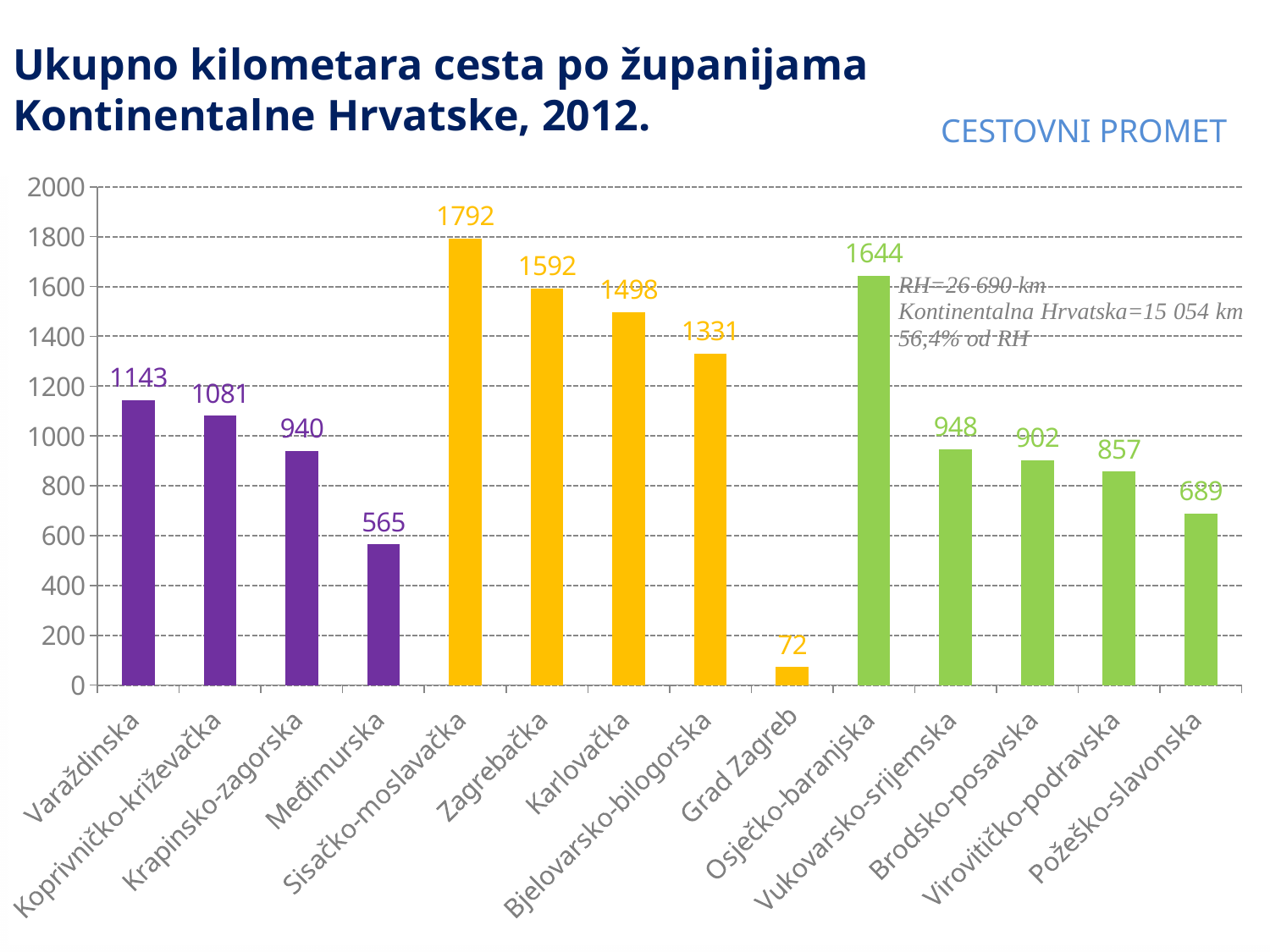
How many different bar colours are used in the chart? 3 What is the value for Vukovarsko-srijemska? 948 Is the value for Međimurska greater or less than 600? less Which is larger, the value for Varaždinska or for Koprivničko-križevačka? Varaždinska How many categories are shown on the x axis? 14 What is the title of the chart? Ukupno kilometara cesta po županijama Kontinentalne Hrvatske, 2012. Which county has the highest value? Sisačko-moslavačka Which category has the lowest value? Grad Zagreb What is the difference between the values for Sisačko-moslavačka and Osječko-baranjska? 148 What is the value for Grad Zagreb? 72 What kind of chart is shown on the slide? bar chart What is the value for Sisačko-moslavačka? 1792